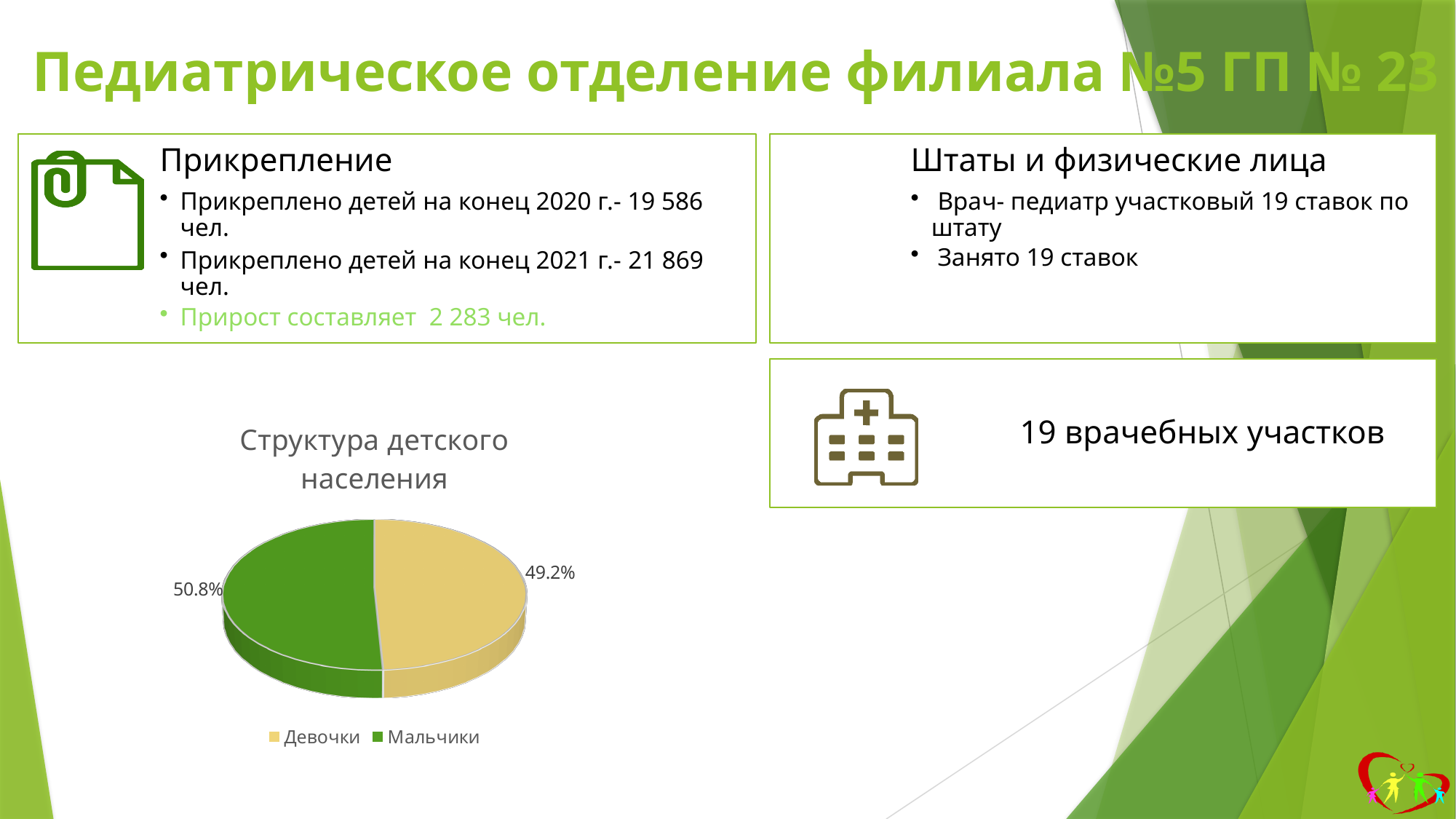
What is the difference between the share for Мальчики and the share for Девочки? 1.6% Which colour represents Девочки in the pie chart? Yellow Which category has the smallest slice of the pie? Девочки What share of the pie does Девочки have? 49.2% How many categories does the pie chart show? 2 How many entries does the chart legend list? 2 What is the title of the chart? Структура детского населения What is the total of the two slices shown in the pie chart? 100% Which category has the largest slice of the pie? Мальчики What kind of chart is shown on the slide? Pie chart Which is larger, the share for Девочки or the share for Мальчики? Мальчики What share of the pie does Мальчики have? 50.8%